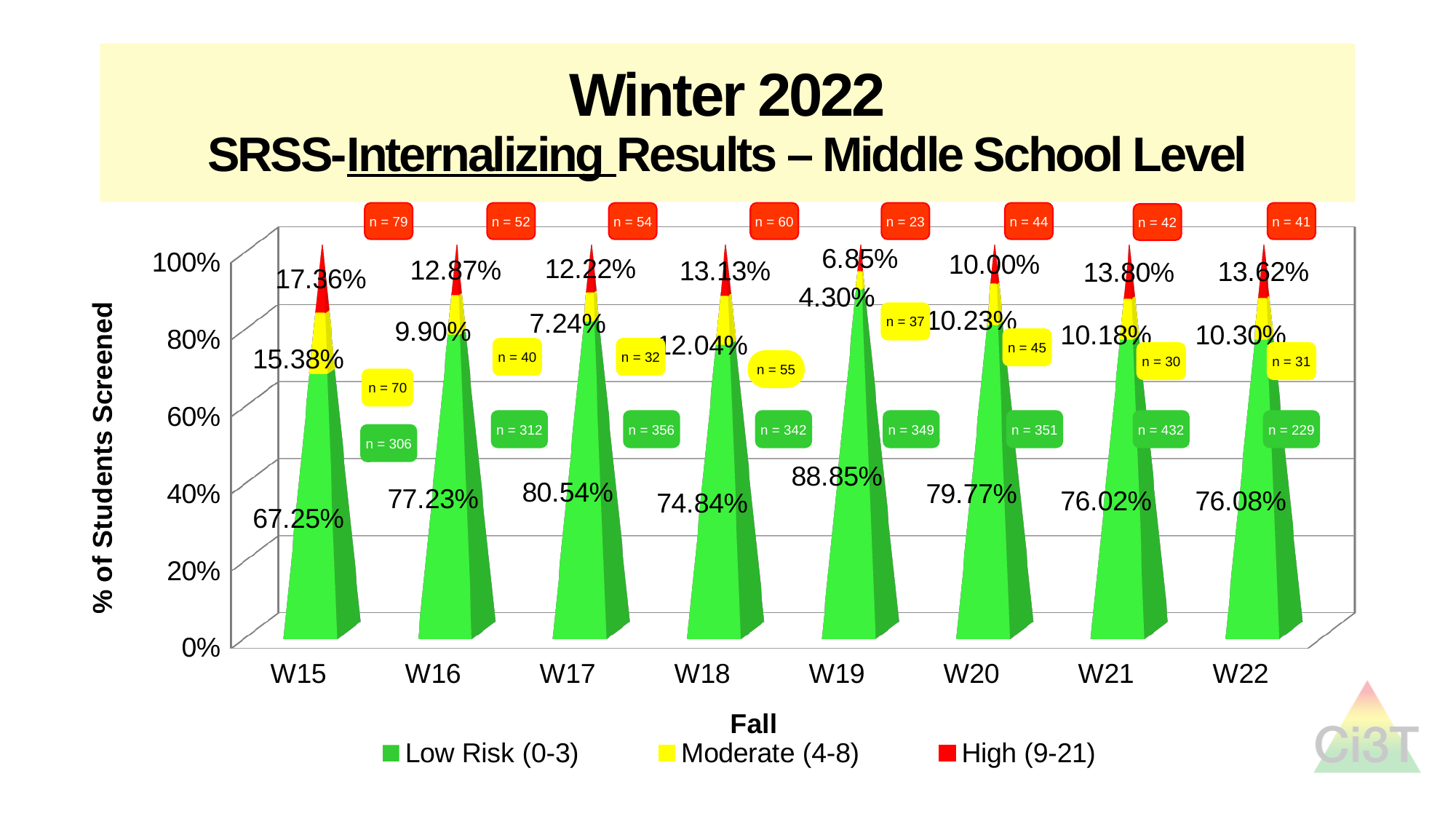
What is the High (9-21) percentage for W19? 6.85% What percentage of students screened at W15 were in the Low Risk (0-3) category? 67.25% What is the title of the chart? Winter 2022 SRSS-Internalizing Results – Middle School Level How many series does the legend list? 3 Which school has the highest High (9-21) percentage? W15 What is the n value shown for the Low Risk (0-3) group at W21? n = 432 What is the Moderate (4-8) percentage for W18? 12.04% Which school has the lowest Low Risk (0-3) percentage? W15 At W18, which is larger: the Moderate (4-8) percentage or the High (9-21) percentage? High (9-21) Which school has the highest Low Risk (0-3) percentage? W19 What is the difference in Low Risk (0-3) percentage between W19 and W15? 21.60 percentage points How many schools are shown on the x axis? 8